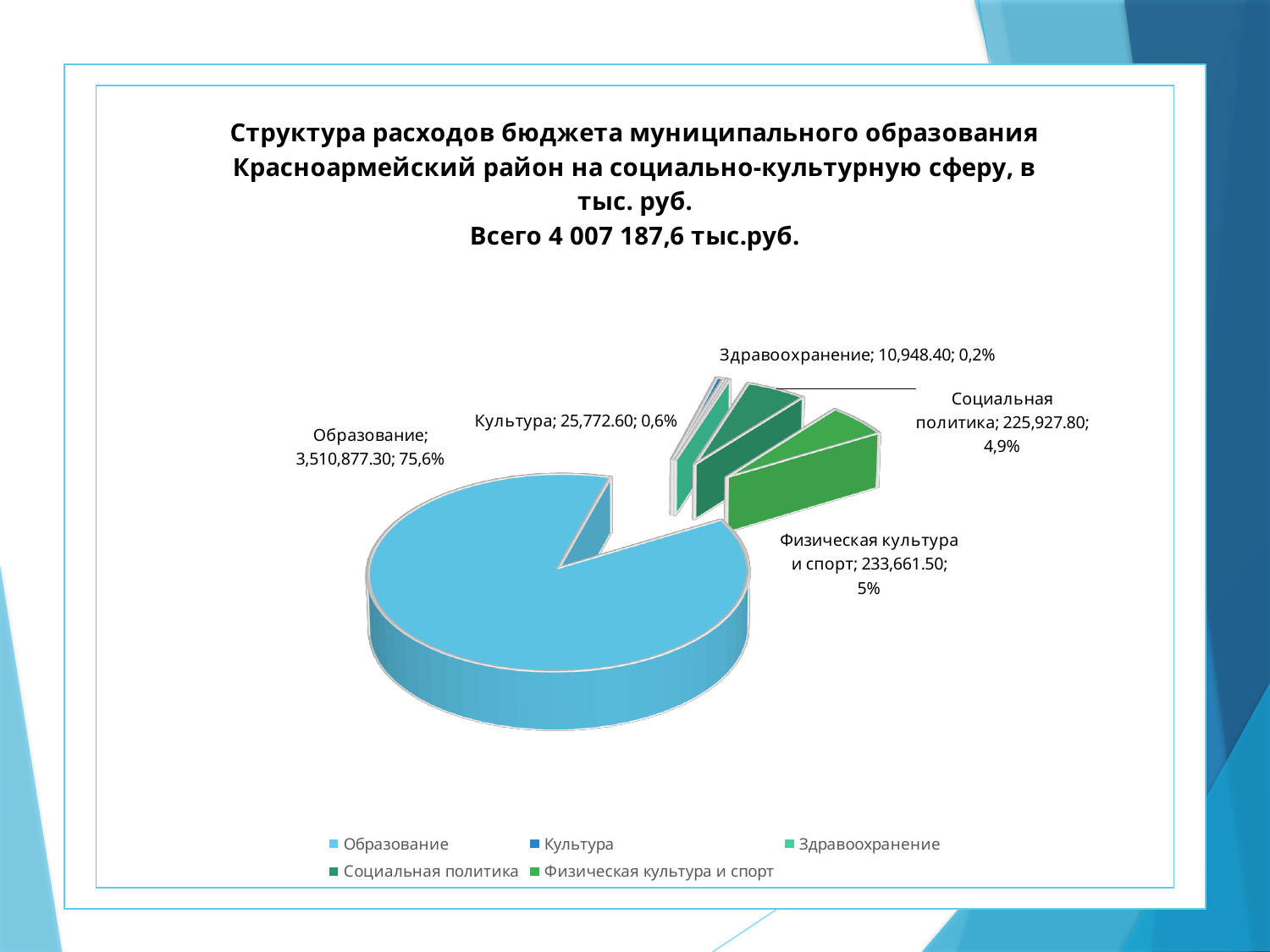
What is the value for Физическая культура и спорт? 233,661.50 Which is larger, Физическая культура и спорт or Социальная политика? Физическая культура и спорт Which category has the largest value? Образование Which category has the smallest value? Здравоохранение What share of the pie does Социальная политика represent? 4,9% What share of the pie does Образование represent? 75,6% What type of chart is shown on the slide? Pie chart What is the value for Здравоохранение? 10,948.40 What total amount is stated in the chart title? 4 007 187,6 тыс.руб. What is the difference between the values for Культура and Здравоохранение? 14,824.20 What is the value for Образование? 3,510,877.30 How many categories does the pie chart show? 5